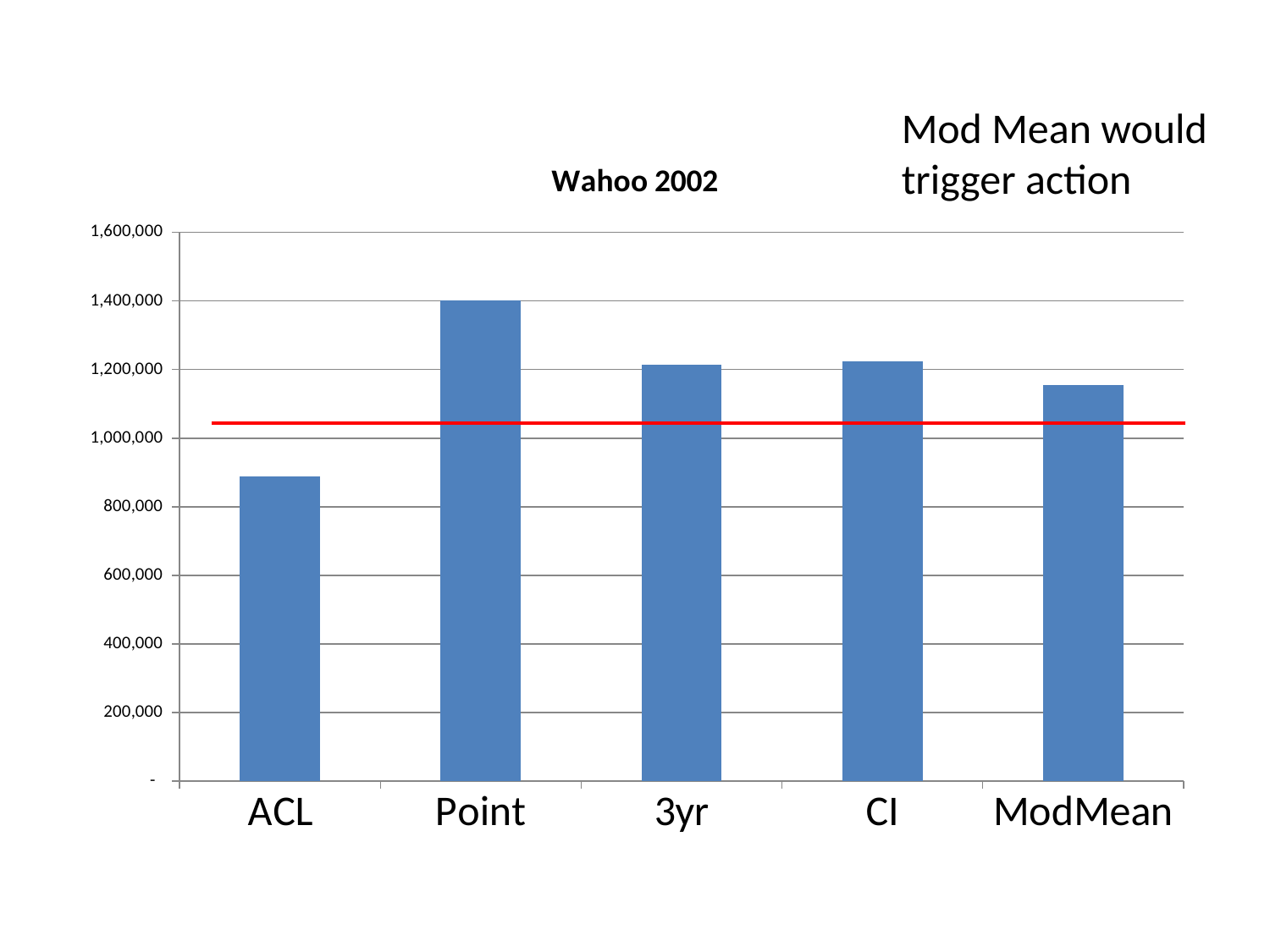
Is the value for ACL greater or less than 1,000,000? less Is the value for Point greater or less than 1,200,000? greater Which is larger, the value for CI or the value for ModMean? CI Which category has the lowest bar? ACL Is the value for ModMean greater or less than 1,200,000? less How many categories are shown on the x axis of the chart? 5 Which is larger, the value for Point or the value for ACL? Point What is the title of the chart? Wahoo 2002 Which category has the highest bar? Point What colour is the horizontal line drawn across the chart? red What type of chart is shown on the slide? bar chart